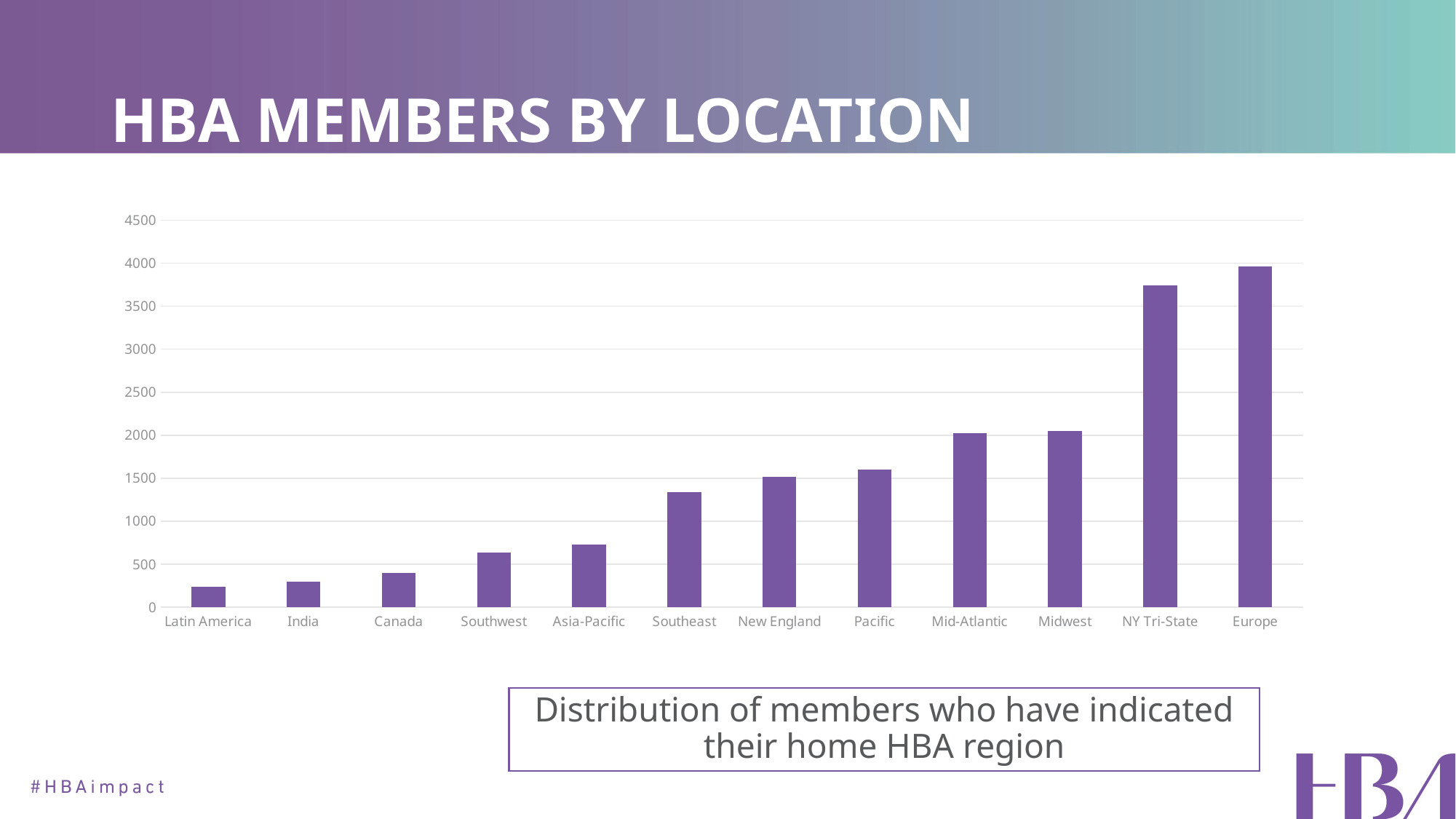
What is the title of the chart on the slide? HBA MEMBERS BY LOCATION Is the value for NY Tri-State greater or less than 3500? greater Which location has the lowest number of HBA members? Latin America What type of chart is shown on the slide? Bar chart Is the value for Southeast greater or less than 1000? greater Is the value for Asia-Pacific greater or less than 500? greater Do the values generally rise or fall moving from left to right along the x axis? rise How many locations are shown on the x axis of the chart? 12 Which location has the highest number of HBA members? Europe Which has more members, Southeast or New England? New England